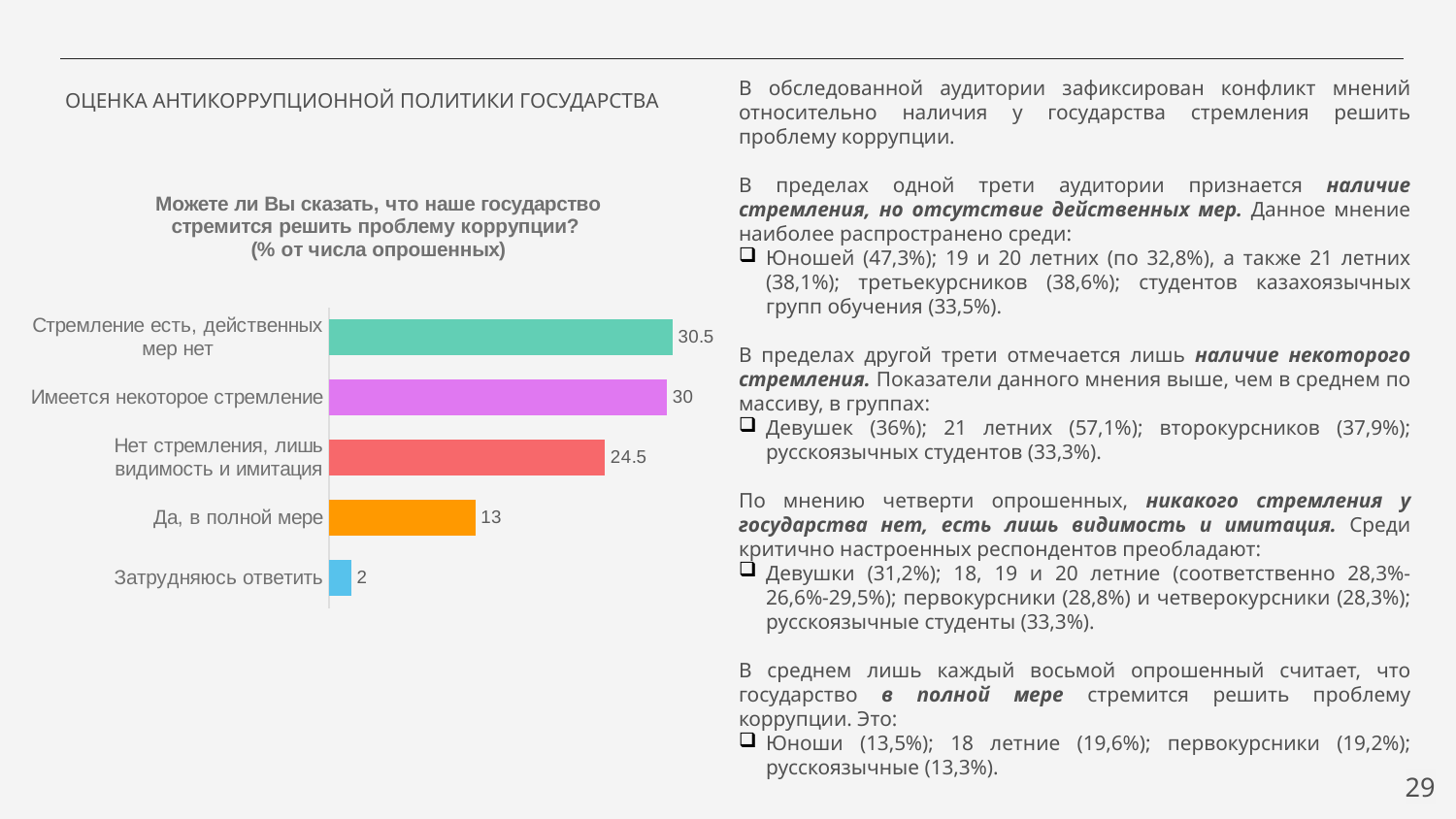
What is the value for "Стремление есть, действенных мер нет"? 30.5 Which category has the lowest value? Затрудняюсь ответить How many categories are shown in the chart? 5 What colour is the bar for "Да, в полной мере"? Orange Which is larger: the value for "Имеется некоторое стремление" or the value for "Нет стремления, лишь видимость и имитация"? Имеется некоторое стремление What is the value for "Имеется некоторое стремление"? 30 What is the value for "Нет стремления, лишь видимость и имитация"? 24.5 What is the value for "Затрудняюсь ответить"? 2 What is the difference between the values for "Нет стремления, лишь видимость и имитация" and "Да, в полной мере"? 11.5 What kind of chart is shown on the slide? Bar chart What is the value for "Да, в полной мере"? 13 Which category has the highest value? Стремление есть, действенных мер нет